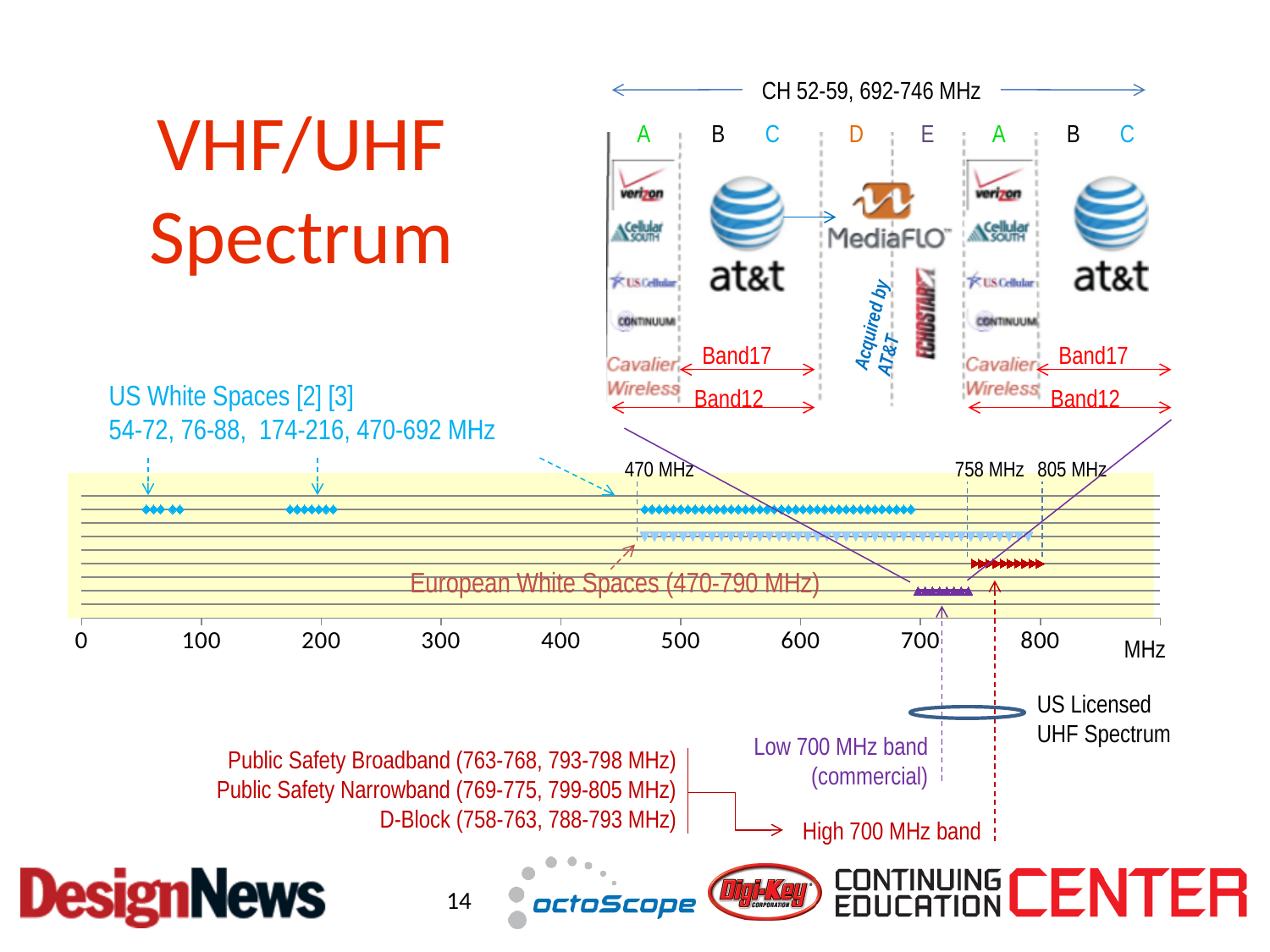
What frequency range is given for the D-Block? 758-763, 788-793 MHz What unit is the x axis of the spectrum chart labeled in? MHz What is the difference between the 805 MHz and 758 MHz markers labeled above the chart? 47 MHz What frequency range is given for Public Safety Broadband? 763-768, 793-798 MHz Which extends to a higher frequency on the chart: the European White Spaces band or the US White Spaces band? European White Spaces What is the highest tick value shown on the x axis of the spectrum chart? 800 What frequency range is given for European White Spaces on the chart? 470-790 MHz Which 700 MHz band is labeled as commercial on the chart? Low 700 MHz band How many numbered tick labels are shown on the x axis of the spectrum chart? 9 What frequency range is labeled for CH 52-59 at the top of the slide? 692-746 MHz What frequency range is given for Public Safety Narrowband? 769-775, 799-805 MHz What frequency ranges are listed for US White Spaces on the chart? 54-72, 76-88, 174-216, 470-692 MHz